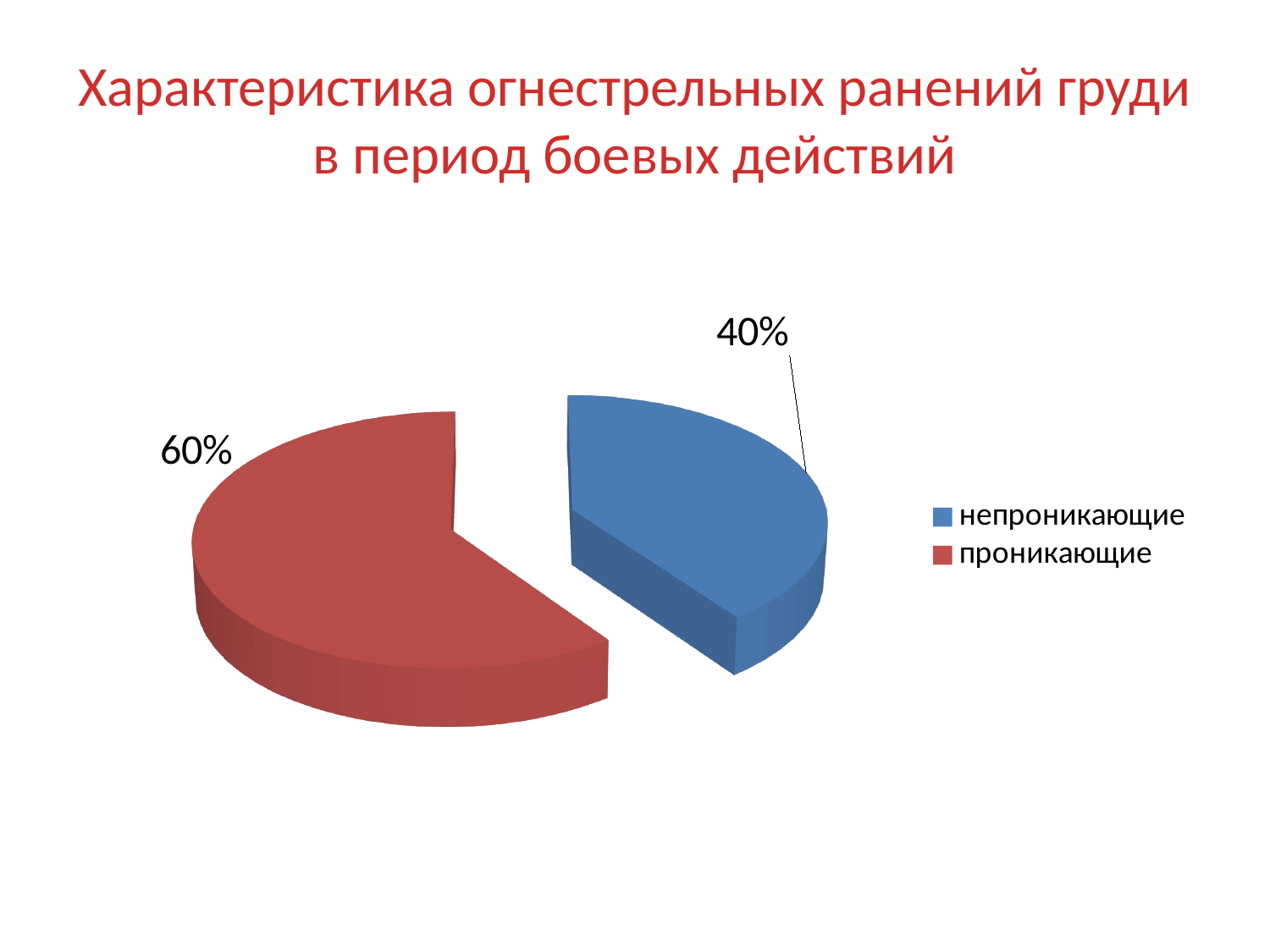
What share of the pie does the непроникающие slice represent? 40% How many categories does the pie chart have? 2 What colour is the проникающие slice? red What share of the pie does the проникающие slice represent? 60% Which category has the smallest slice of the pie? непроникающие What is the difference in percentage points between the проникающие and непроникающие slices? 20% What colour is the непроникающие slice? blue Which category has the largest slice of the pie? проникающие How many entries does the legend list? 2 Which is larger, the непроникающие slice or the проникающие slice? проникающие What kind of chart is shown on the slide? pie chart